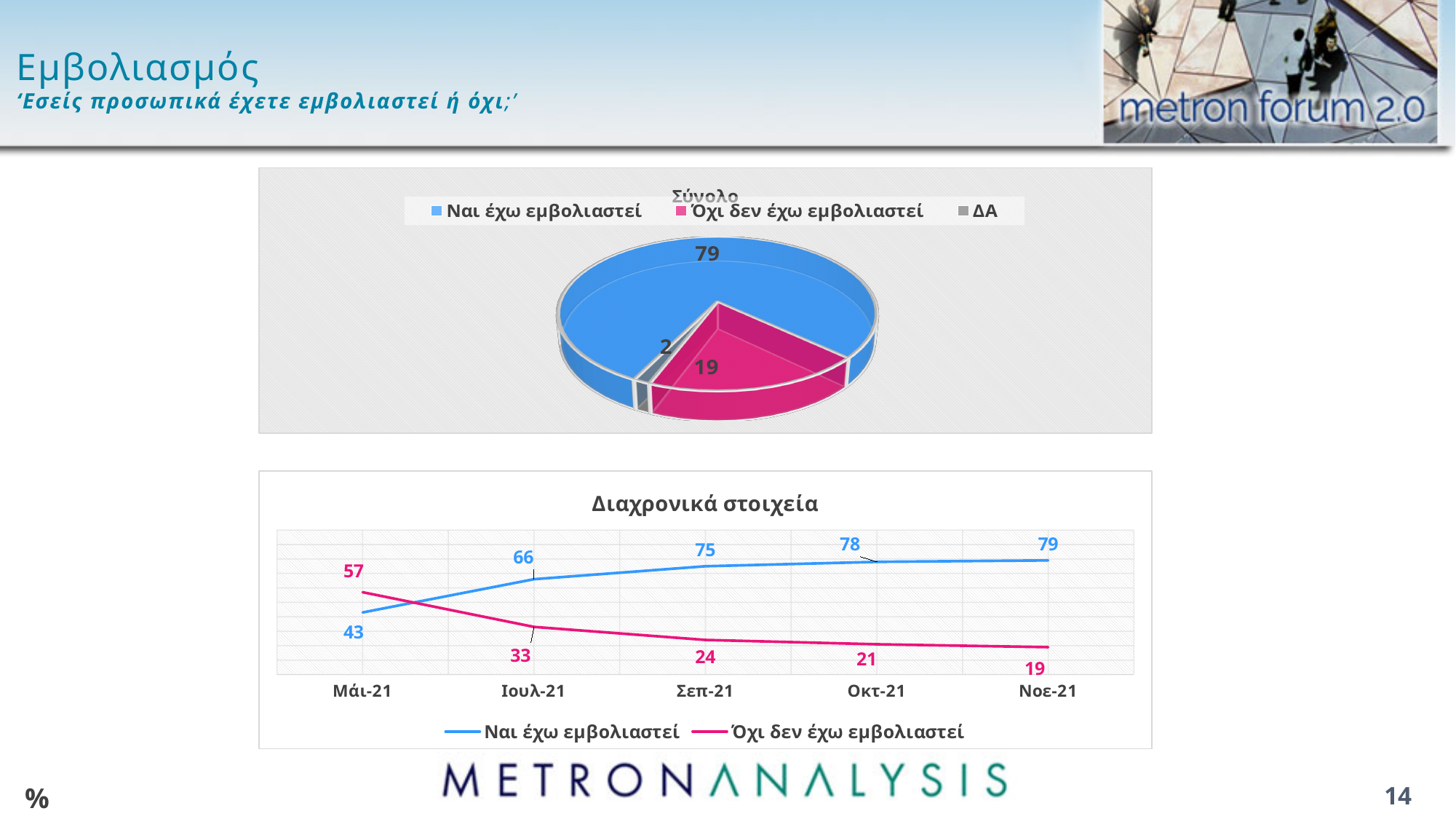
How many time points are shown on the x axis of the bottom chart titled 'Διαχρονικά στοιχεία'? 5 What kind of chart is the top chart titled 'Σύνολο'? Pie chart In the bottom chart titled 'Διαχρονικά στοιχεία', what is the value for 'Όχι δεν έχω εμβολιαστεί' in Σεπ-21? 24 In the bottom chart titled 'Διαχρονικά στοιχεία', what is the difference between 'Ναι έχω εμβολιαστεί' and 'Όχι δεν έχω εμβολιαστεί' in Νοε-21? 60 How many series does the legend of the bottom chart titled 'Διαχρονικά στοιχεία' list? 2 How many slices does the top chart titled 'Σύνολο' have? 3 In the bottom chart titled 'Διαχρονικά στοιχεία', does the 'Όχι δεν έχω εμβολιαστεί' series rise or fall from Μάι-21 to Νοε-21? Fall In the top chart titled 'Σύνολο', which category has the smallest slice? ΔΑ In the top chart titled 'Σύνολο', what is the value for 'Ναι έχω εμβολιαστεί'? 79 In the top chart titled 'Σύνολο', what is the value for 'ΔΑ'? 2 In the bottom chart titled 'Διαχρονικά στοιχεία', which series has the higher value in Μάι-21? Όχι δεν έχω εμβολιαστεί In the bottom chart titled 'Διαχρονικά στοιχεία', what is the value for 'Ναι έχω εμβολιαστεί' in Μάι-21? 43